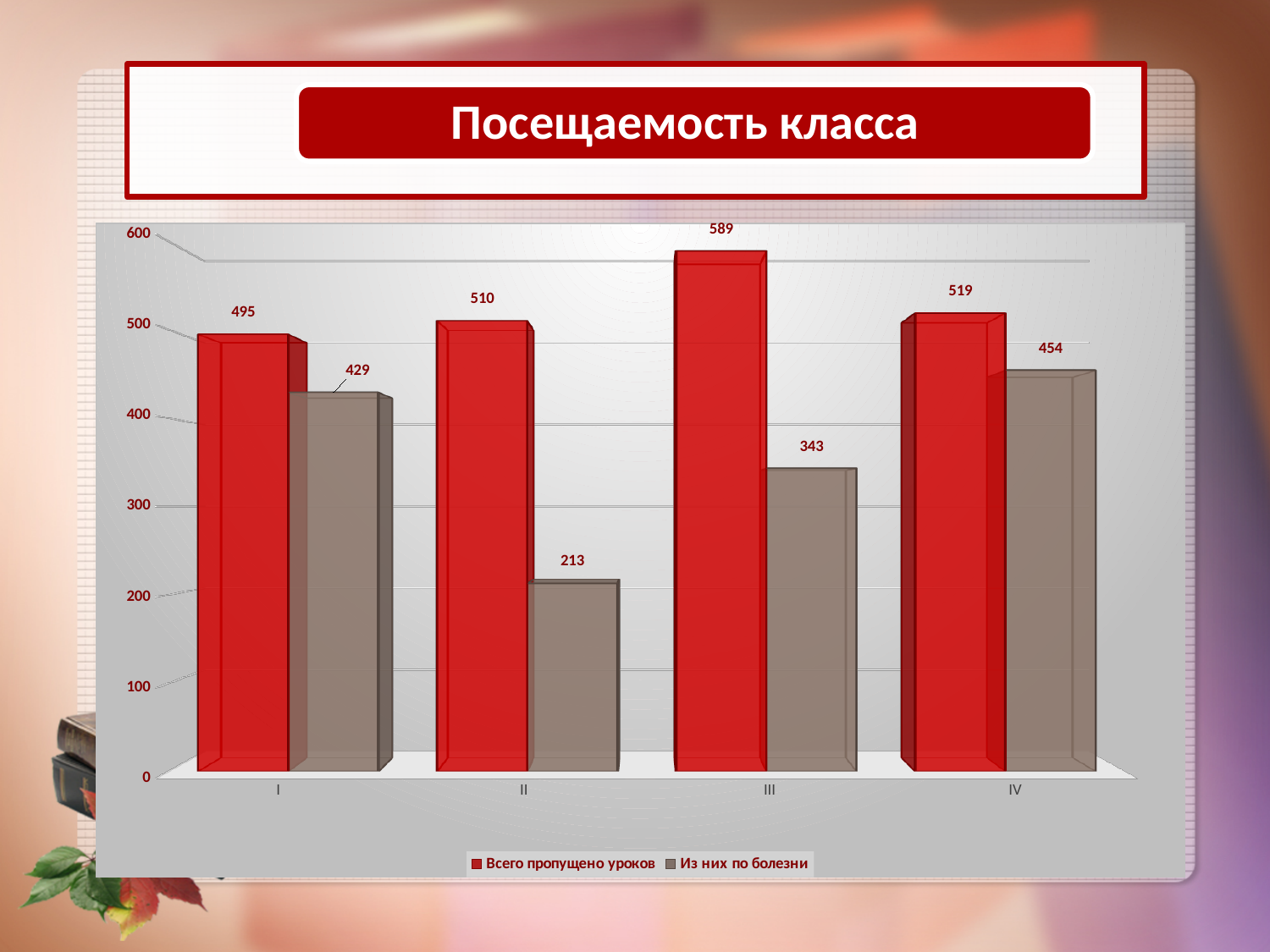
What is the value of "Из них по болезни" for category II? 213 Which category has the lowest value for "Из них по болезни"? II What is the difference between "Всего пропущено уроков" for category III and category I? 94 What is the value of "Из них по болезни" for category IV? 454 What is the value of "Всего пропущено уроков" for category III? 589 What kind of chart is shown on the slide? Bar chart Which is larger: "Из них по болезни" for category I or for category IV? IV What is the difference between "Всего пропущено уроков" and "Из них по болезни" for category II? 297 Which category has the highest value for "Всего пропущено уроков"? III What is the title of the slide? Посещаемость класса How many series does the legend list? 2 How many categories are shown on the x axis? 4